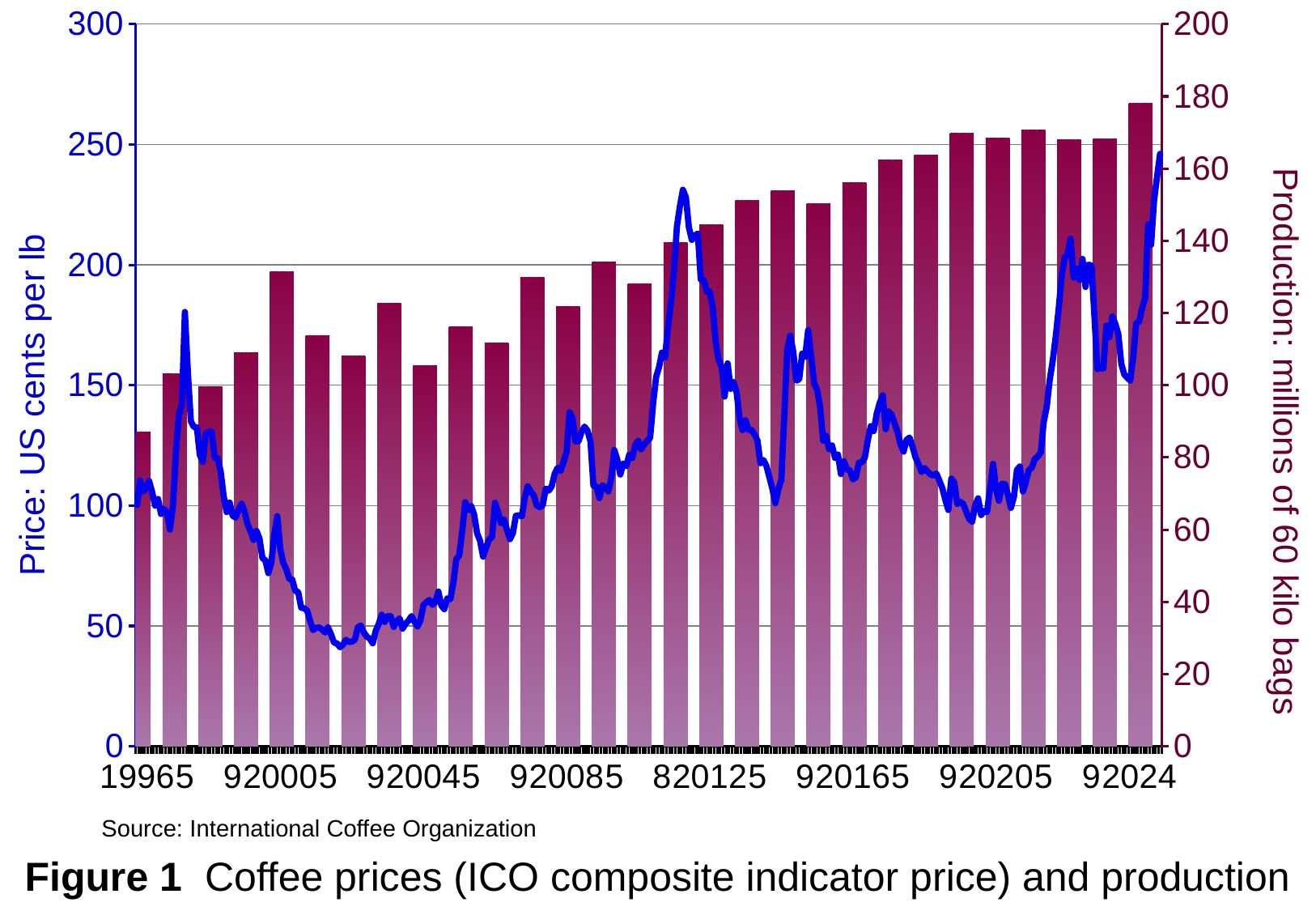
Do the production bars generally rise or fall from left to right along the x axis? rise What is the label of the right vertical axis? Production: millions of 60 kilo bags Is the production value for the leftmost bar greater or less than 100 million bags? less Which bar shows the highest production? The rightmost (last) bar Is the leftmost production bar taller or shorter than the rightmost production bar? shorter Is the lowest point of the price line greater or less than 50 US cents per lb? less Is the production value for the rightmost (tallest) bar greater or less than 160 million bags? greater What is the label of the left vertical axis? Price: US cents per lb What kind of chart is shown on the slide? A bar chart combined with a line chart